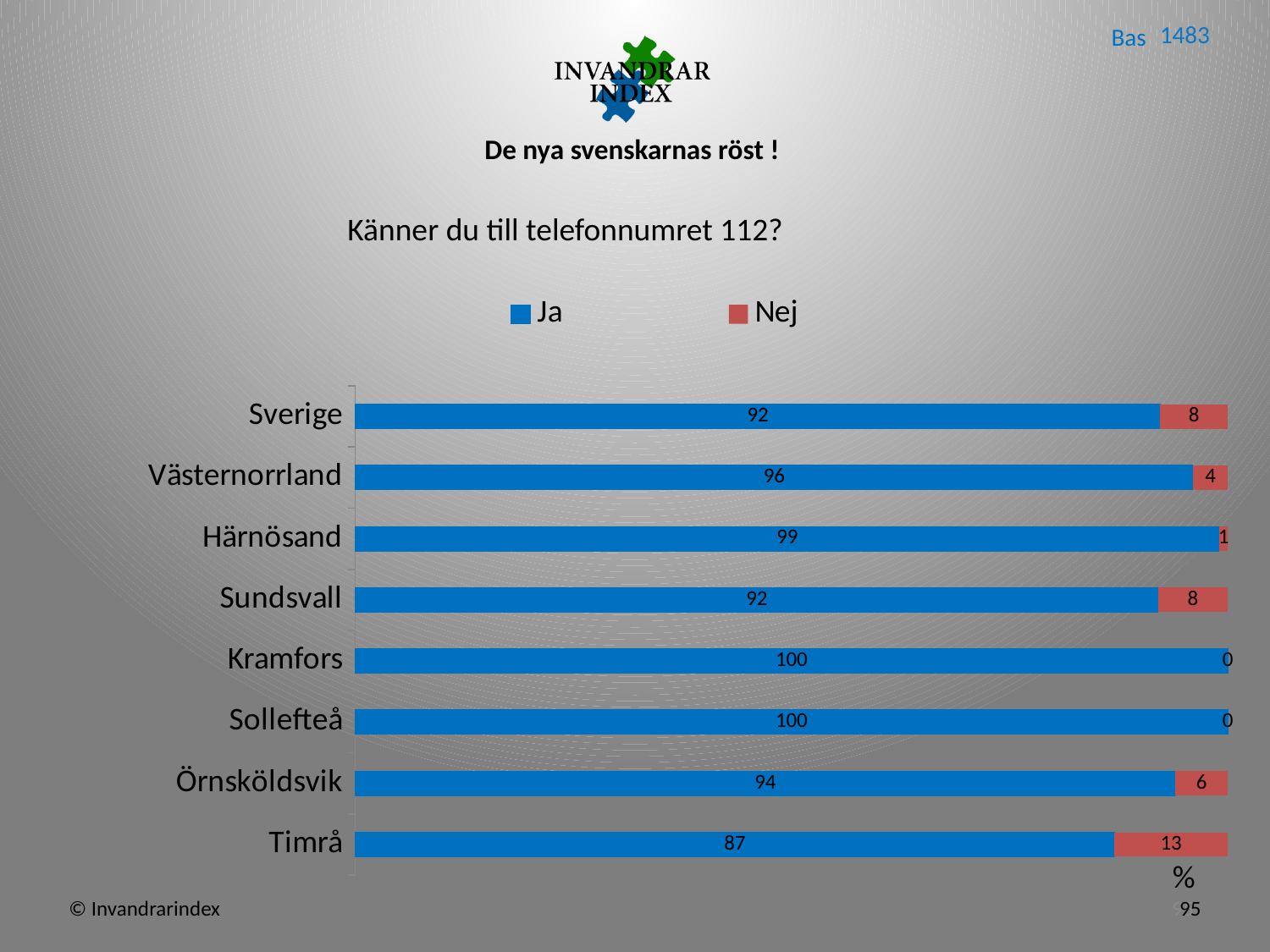
What is the "Ja" value for Timrå? 87 What is the difference between the "Ja" values for Västernorrland and Sundsvall? 4 What question is the chart about, according to its title? Känner du till telefonnumret 112? What is the total of the stacked bar for Sundsvall? 100 What kind of chart is shown? Stacked bar chart Which is larger, the "Nej" value for Örnsköldsvik or for Västernorrland? Örnsköldsvik How many categories are shown on the chart? 8 How many series does the legend list? 2 What is the "Nej" value for Sverige? 8 Which category has the highest "Nej" value? Timrå What is the "Ja" value for Härnösand? 99 Which category has the lowest "Ja" value? Timrå